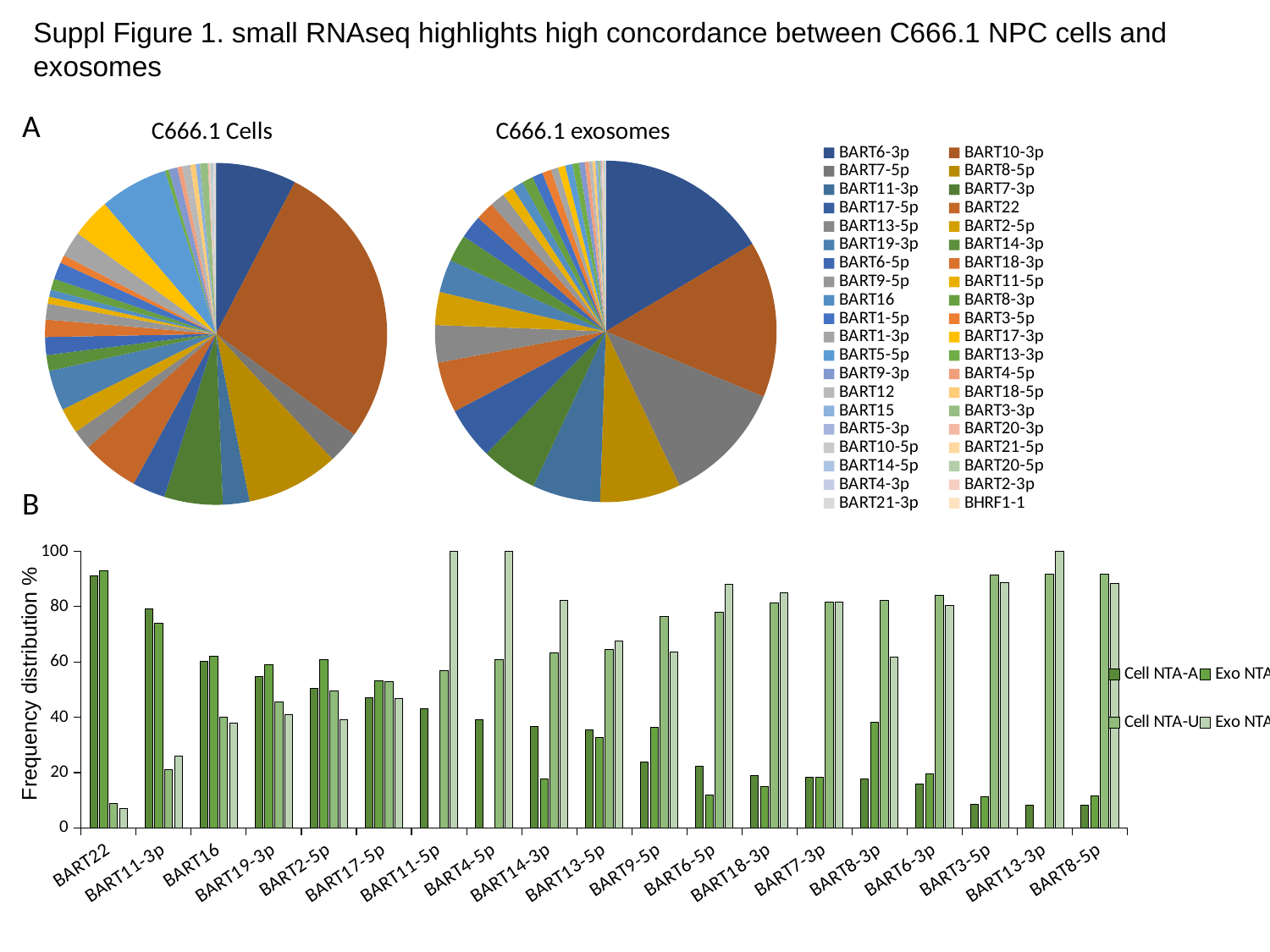
In the bar chart in panel B, which is larger for BART22: the Cell NTA-A value or the Cell NTA-U value? Cell NTA-A How many categories are shown on the x axis of the bar chart in panel B? 19 In the bar chart in panel B, is the Cell NTA-U value for BART22 greater or less than 20? less In the bar chart in panel B, is the Cell NTA-A value for BART11-3p greater or less than 60? greater What kind of charts are the two charts in panel A? pie charts In the bar chart in panel B, is the Cell NTA-U value for BART6-5p greater or less than 20? greater What kind of chart is panel B at the bottom of the slide? bar chart How many series does the legend of the bar chart in panel B list? 4 In the bar chart in panel B, which is larger for BART11-5p: the Cell NTA-A value or the Cell NTA-U value? Cell NTA-U In the C666.1 Cells pie chart, which category has the largest slice? BART10-3p In the C666.1 exosomes pie chart, which category has the largest slice? BART6-3p